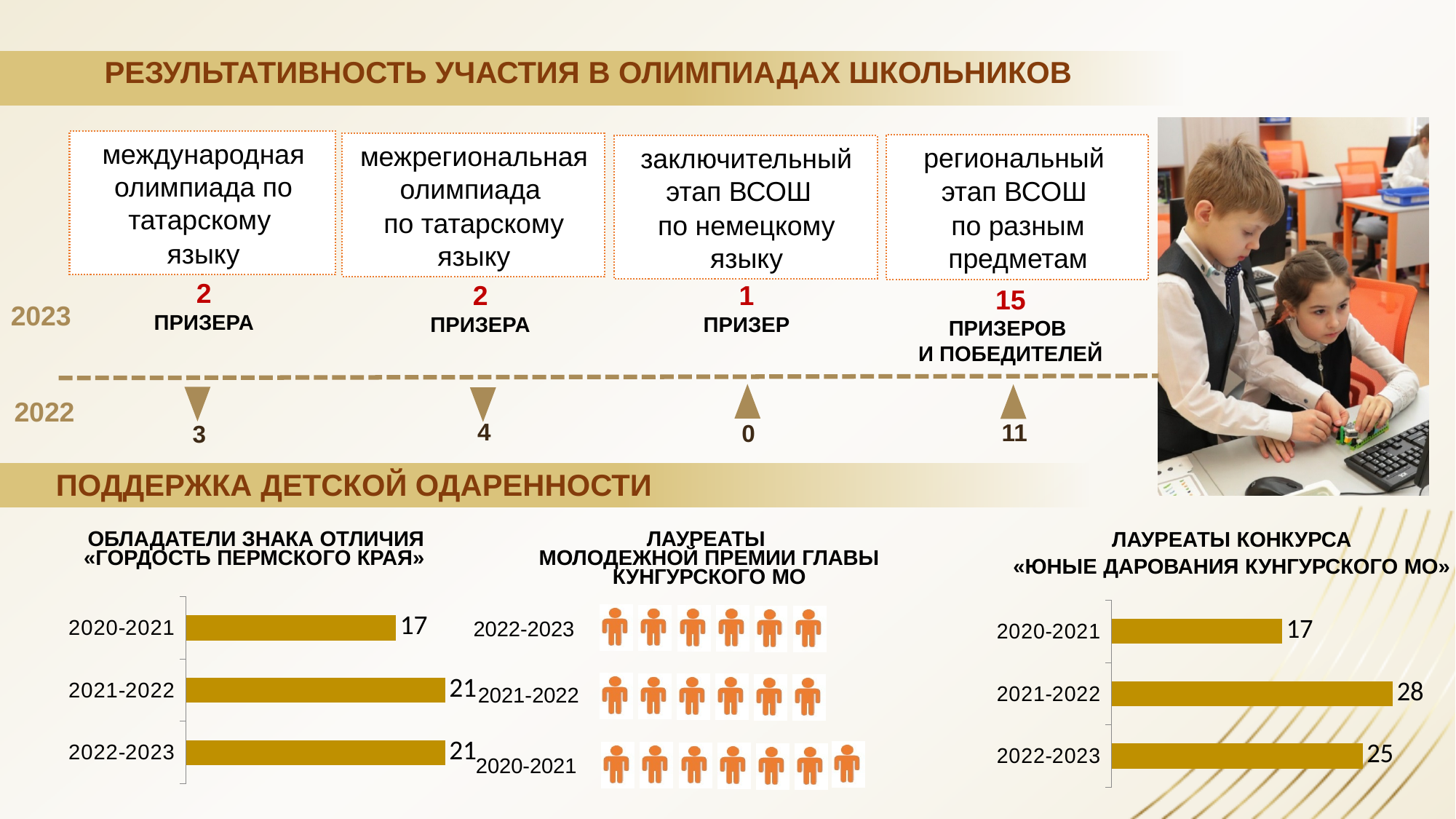
In the chart titled «ОБЛАДАТЕЛИ ЗНАКА ОТЛИЧИЯ «ГОРДОСТЬ ПЕРМСКОГО КРАЯ»», what is the difference between the values for 2021-2022 and 2020-2021? 4 In the chart titled «ОБЛАДАТЕЛИ ЗНАКА ОТЛИЧИЯ «ГОРДОСТЬ ПЕРМСКОГО КРАЯ»», how many periods are shown? 3 In the chart titled «ОБЛАДАТЕЛИ ЗНАКА ОТЛИЧИЯ «ГОРДОСТЬ ПЕРМСКОГО КРАЯ»», what is the value for 2022-2023? 21 In the chart titled «ЛАУРЕАТЫ КОНКУРСА «ЮНЫЕ ДАРОВАНИЯ КУНГУРСКОГО МО»», what is the value for 2021-2022? 28 In the chart titled «ЛАУРЕАТЫ КОНКУРСА «ЮНЫЕ ДАРОВАНИЯ КУНГУРСКОГО МО»», which period has the highest value? 2021-2022 In the chart titled «ЛАУРЕАТЫ КОНКУРСА «ЮНЫЕ ДАРОВАНИЯ КУНГУРСКОГО МО»», which is larger: the value for 2021-2022 or 2022-2023? 2021-2022 In the chart titled «ЛАУРЕАТЫ КОНКУРСА «ЮНЫЕ ДАРОВАНИЯ КУНГУРСКОГО МО»», what is the total of the values for all three periods? 70 What type of chart is the one titled «ОБЛАДАТЕЛИ ЗНАКА ОТЛИЧИЯ «ГОРДОСТЬ ПЕРМСКОГО КРАЯ»»? bar chart In the chart titled «ЛАУРЕАТЫ КОНКУРСА «ЮНЫЕ ДАРОВАНИЯ КУНГУРСКОГО МО»», what is the difference between the values for 2021-2022 and 2020-2021? 11 In the chart titled «ОБЛАДАТЕЛИ ЗНАКА ОТЛИЧИЯ «ГОРДОСТЬ ПЕРМСКОГО КРАЯ»», which period has the lowest value? 2020-2021 In the chart titled «ЛАУРЕАТЫ КОНКУРСА «ЮНЫЕ ДАРОВАНИЯ КУНГУРСКОГО МО»», what is the value for 2022-2023? 25 In the chart titled «ОБЛАДАТЕЛИ ЗНАКА ОТЛИЧИЯ «ГОРДОСТЬ ПЕРМСКОГО КРАЯ»», what is the value for 2020-2021? 17